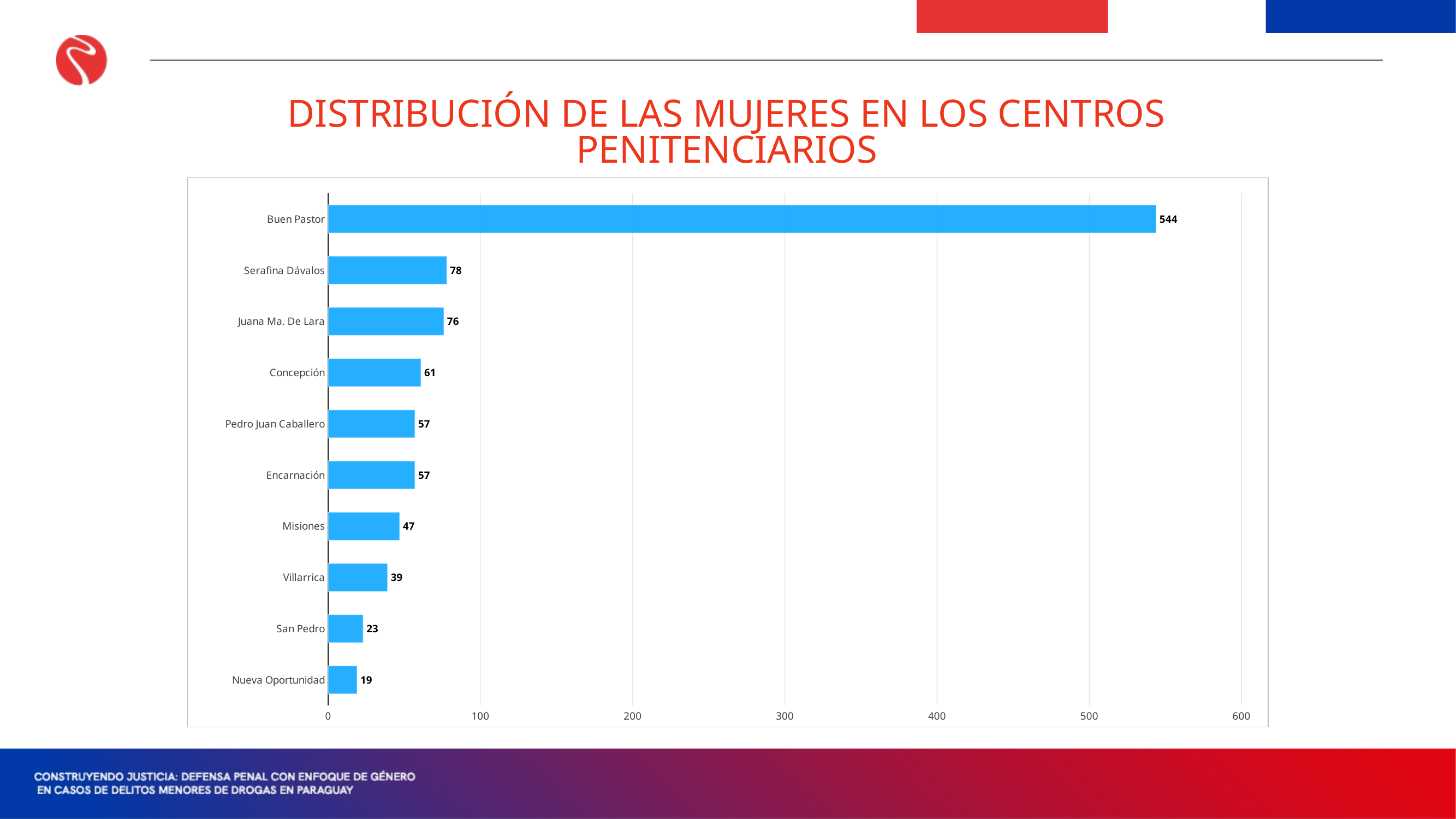
Which centre has the lowest value? Nueva Oportunidad Which is larger, the value for Juana Ma. De Lara or the value for Concepción? Juana Ma. De Lara What kind of chart is shown on the slide? bar chart Is the value for Buen Pastor greater or less than 500? greater What is the value for Villarrica? 39 Which centre has the highest value? Buen Pastor What is the difference between the values for Misiones and San Pedro? 24 What is the value for Concepción? 61 What is the value for Buen Pastor? 544 What is the difference between the values for Buen Pastor and Serafina Dávalos? 466 What is the title of the slide? DISTRIBUCIÓN DE LAS MUJERES EN LOS CENTROS PENITENCIARIOS How many centres are shown in the chart? 10